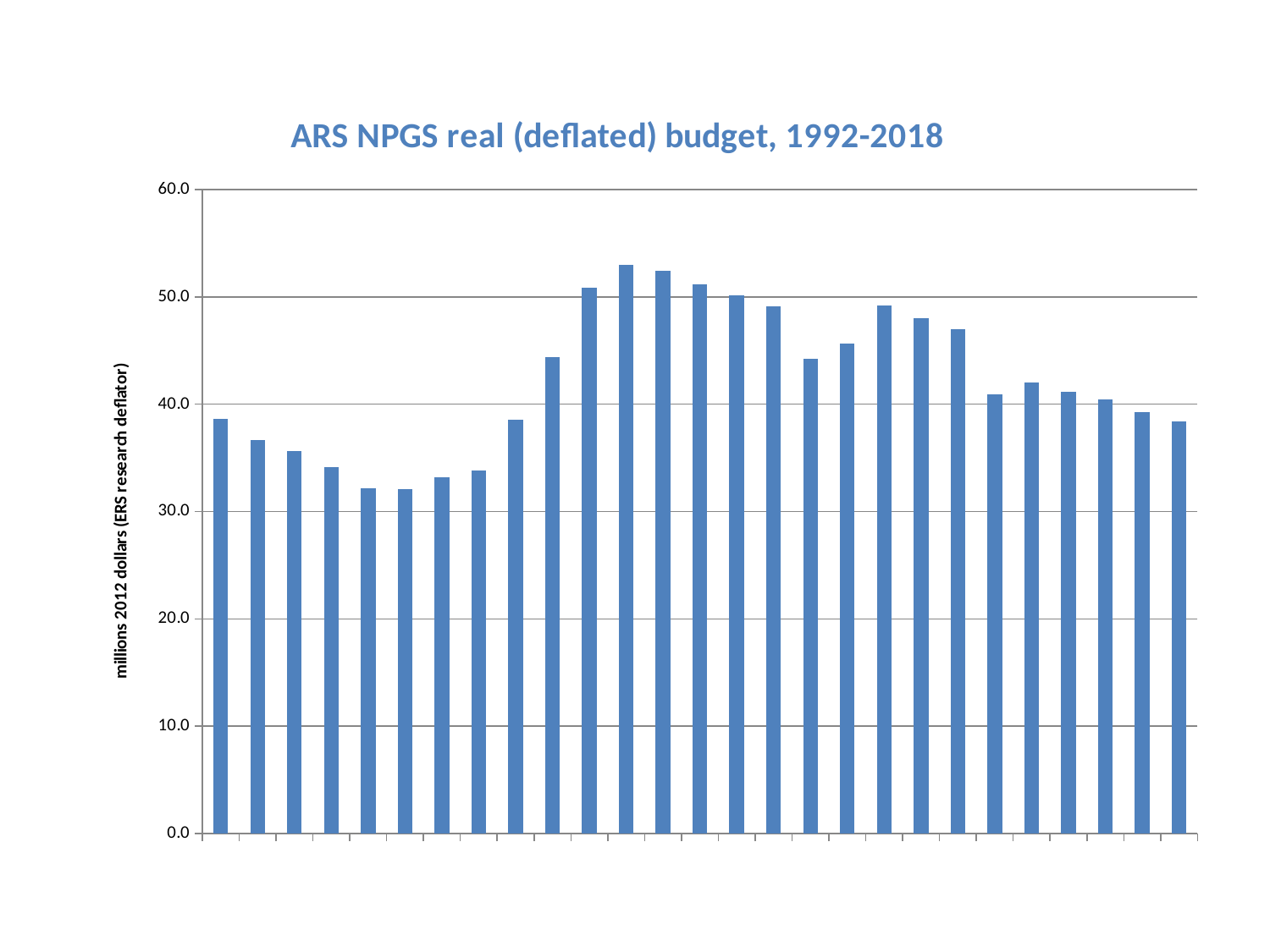
What is the title of the chart? ARS NPGS real (deflated) budget, 1992-2018 How many data series are plotted in the chart? 1 What kind of chart is shown on the slide? bar chart Is the value of the last (rightmost) bar greater or less than 40? less Is the value of the shortest bar greater or less than 30? greater Which is larger, the value of the tallest bar or the value of the first (leftmost) bar? the tallest bar Is the value of the tallest bar greater or less than 50? greater How many bars are plotted in the chart? 27 Do the values rise or fall from the tallest bar to the last (rightmost) bar? fall What is the label on the vertical axis of the chart? millions 2012 dollars (ERS research deflator)